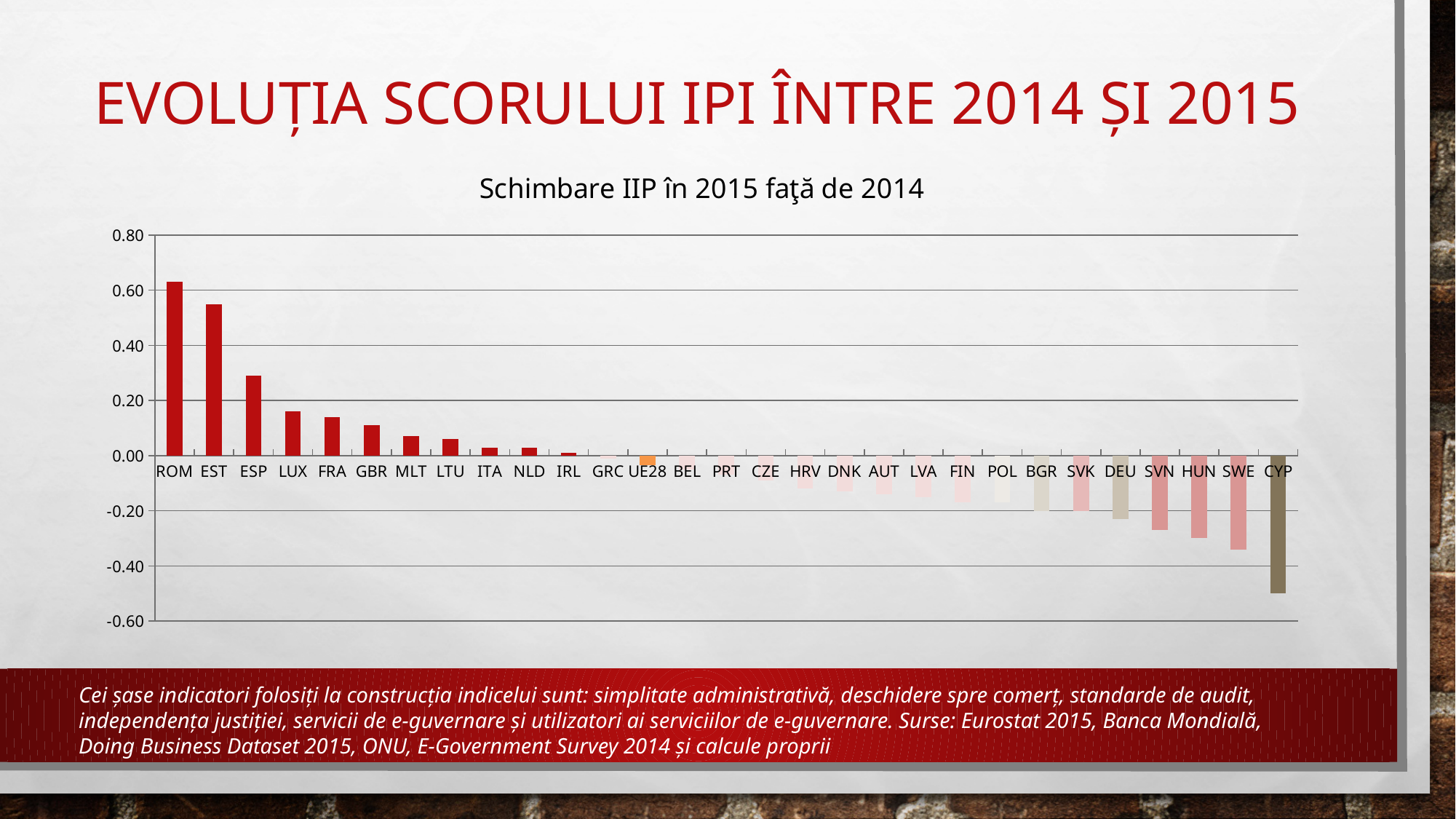
Which category has the lowest value in the chart? CYP What kind of chart is shown on the slide? bar chart Which category has the highest value in the chart? ROM What is the title of the chart? Schimbare IIP în 2015 faţă de 2014 Is the value for ROM greater or less than 0.40? greater Is the value for LUX greater or less than 0.20? less Do the values rise or fall moving from left to right along the x axis? fall Which has the larger value, ROM or EST? ROM Which has the larger value, SWE or CYP? SWE Is the value for ESP greater or less than 0.20? greater How many categories are plotted on the x axis of the chart? 29